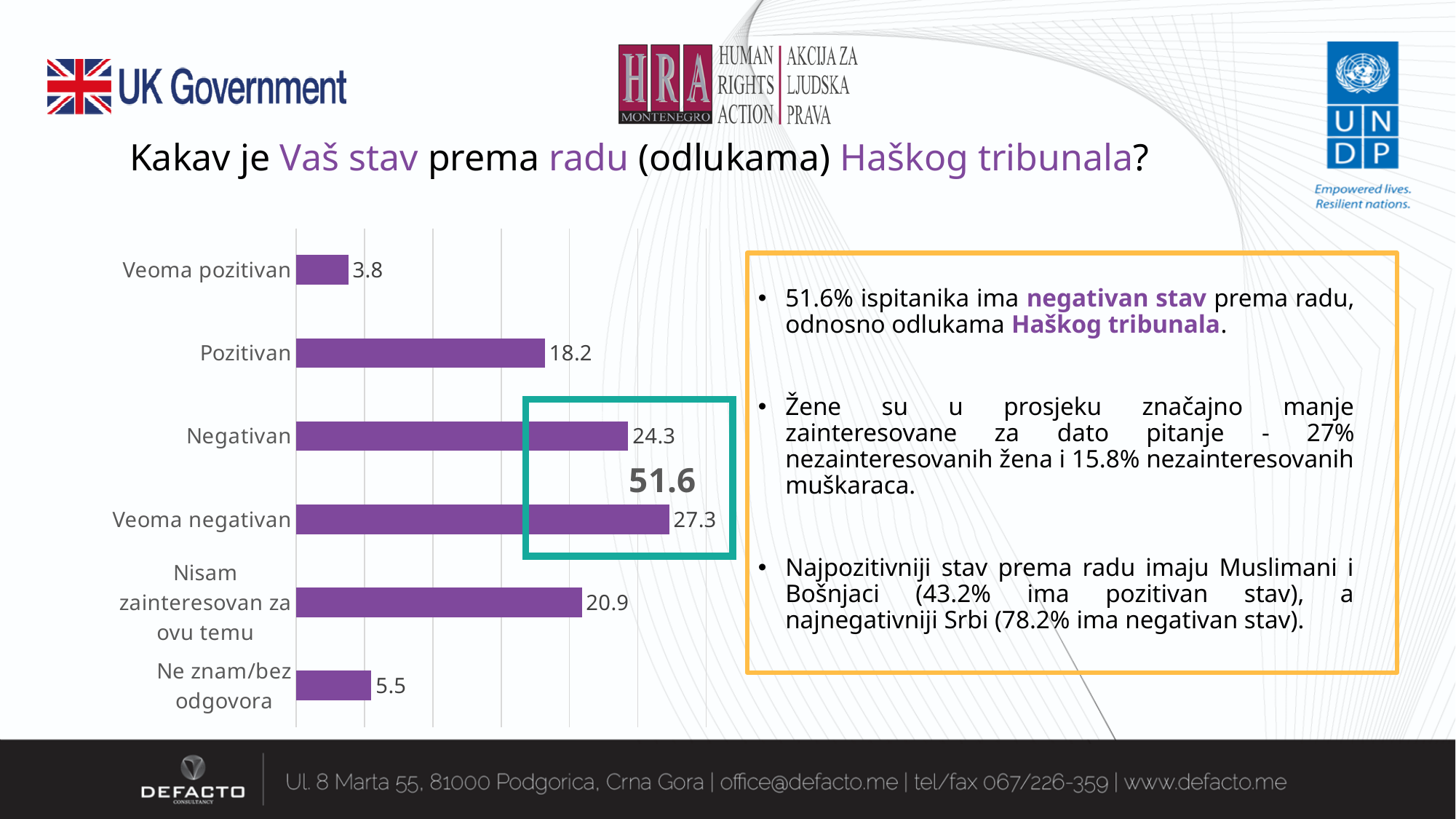
What value is shown for "Ne znam/bez odgovora"? 5.5 What value is shown for "Nisam zainteresovan za ovu temu"? 20.9 What combined value is printed inside the green box around the "Negativan" and "Veoma negativan" bars? 51.6 Which category has the highest value? Veoma negativan How many categories are shown in the chart? 6 Which category has the lowest value? Veoma pozitivan What is the difference between the values for "Pozitivan" and "Veoma pozitivan"? 14.4 Which is larger, the value for "Negativan" or the value for "Nisam zainteresovan za ovu temu"? Negativan What kind of chart is shown on the slide? Bar chart What value is shown for "Veoma negativan"? 27.3 What is the difference between the values for "Veoma negativan" and "Negativan"? 3.0 What value is shown for "Pozitivan"? 18.2